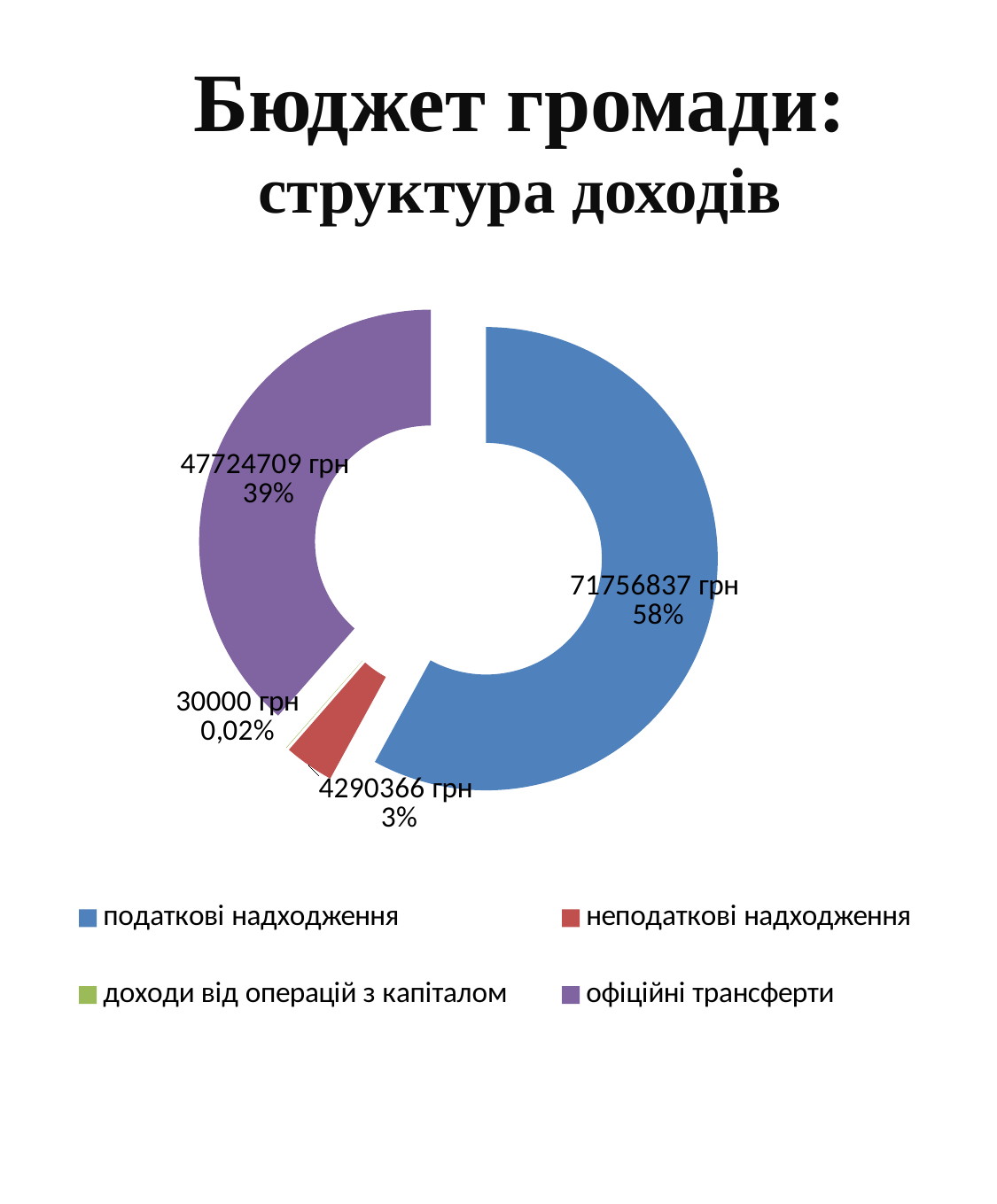
What is the value for доходи від операцій з капіталом? 30000 грн What kind of chart is shown on the slide? doughnut chart What share of the total do податкові надходження make up? 58% What is the value for офіційні трансферти? 47724709 грн Which category has the smallest value? доходи від операцій з капіталом What is the value for податкові надходження? 71756837 грн What share of the total do офіційні трансферти make up? 39% What is the difference between податкові надходження and офіційні трансферти? 24032128 грн How many categories does the legend list? 4 Which category has the largest value? податкові надходження What is the value for неподаткові надходження? 4290366 грн What share of the total do доходи від операцій з капіталом make up? 0,02%